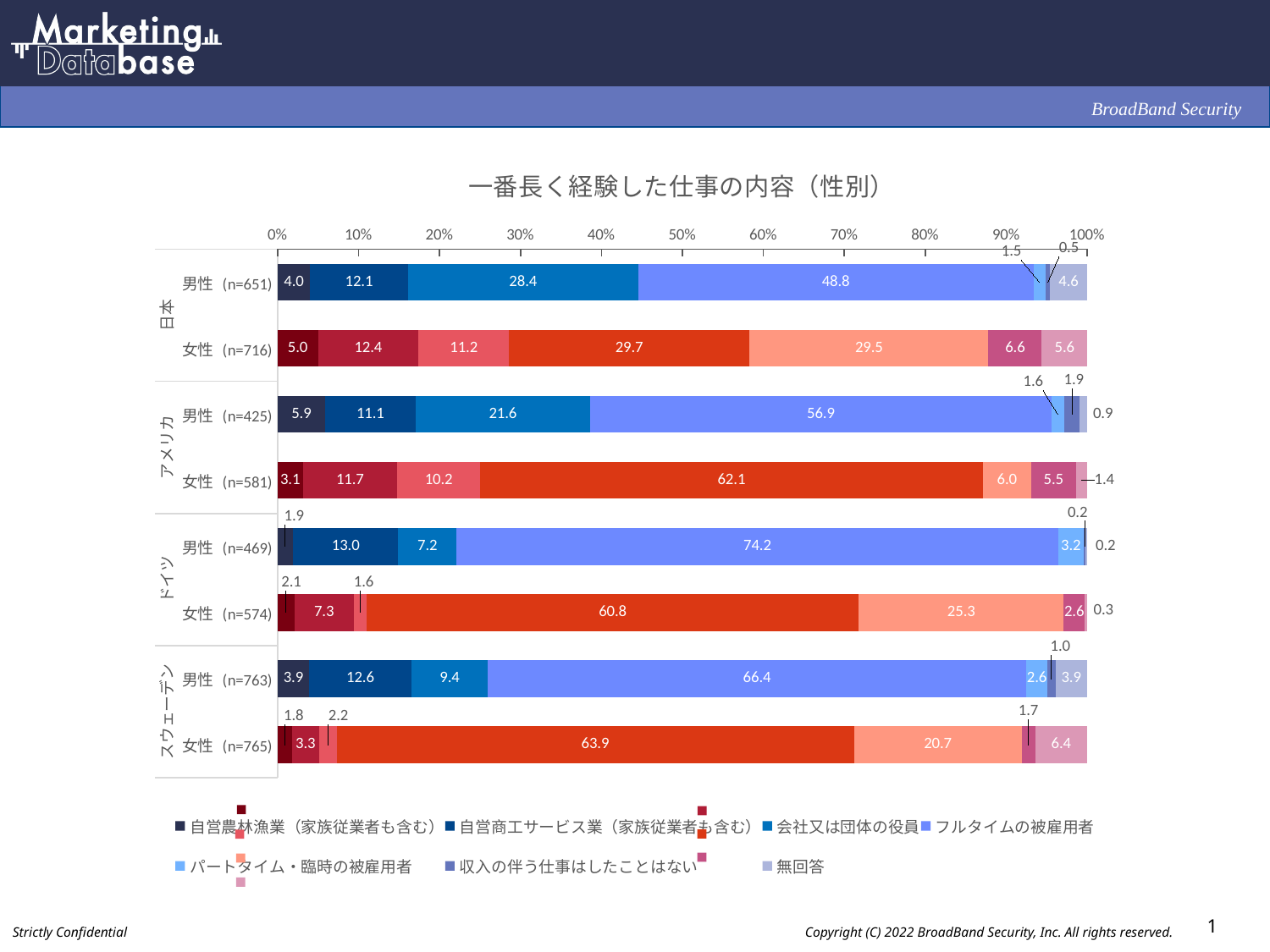
How many bars (gender-by-country groups) are plotted in the chart? 8 What is the value of 無回答 for スウェーデン 男性 (n=763)? 3.9 What is the value of 会社又は団体の役員 for アメリカ 男性 (n=425)? 21.6 What is the value of フルタイムの被雇用者 for 日本 男性 (n=651)? 48.8 Which is larger: the 会社又は団体の役員 value for 日本 男性 (n=651) or for スウェーデン 男性 (n=763)? 日本 男性 (n=651) What is the title of the chart? 一番長く経験した仕事の内容（性別） What is the difference between the フルタイムの被雇用者 values for ドイツ 男性 (n=469) and 日本 男性 (n=651)? 25.4 What is the value of 自営商工サービス業（家族従業者も含む） for ドイツ 男性 (n=469)? 13.0 How many series does the legend list? 7 What type of chart is shown on the slide? stacked bar chart Among the four 男性 bars, which has the highest value for フルタイムの被雇用者? ドイツ 男性 (n=469) What is the value of the largest segment in the 日本 女性 (n=716) bar? 29.7